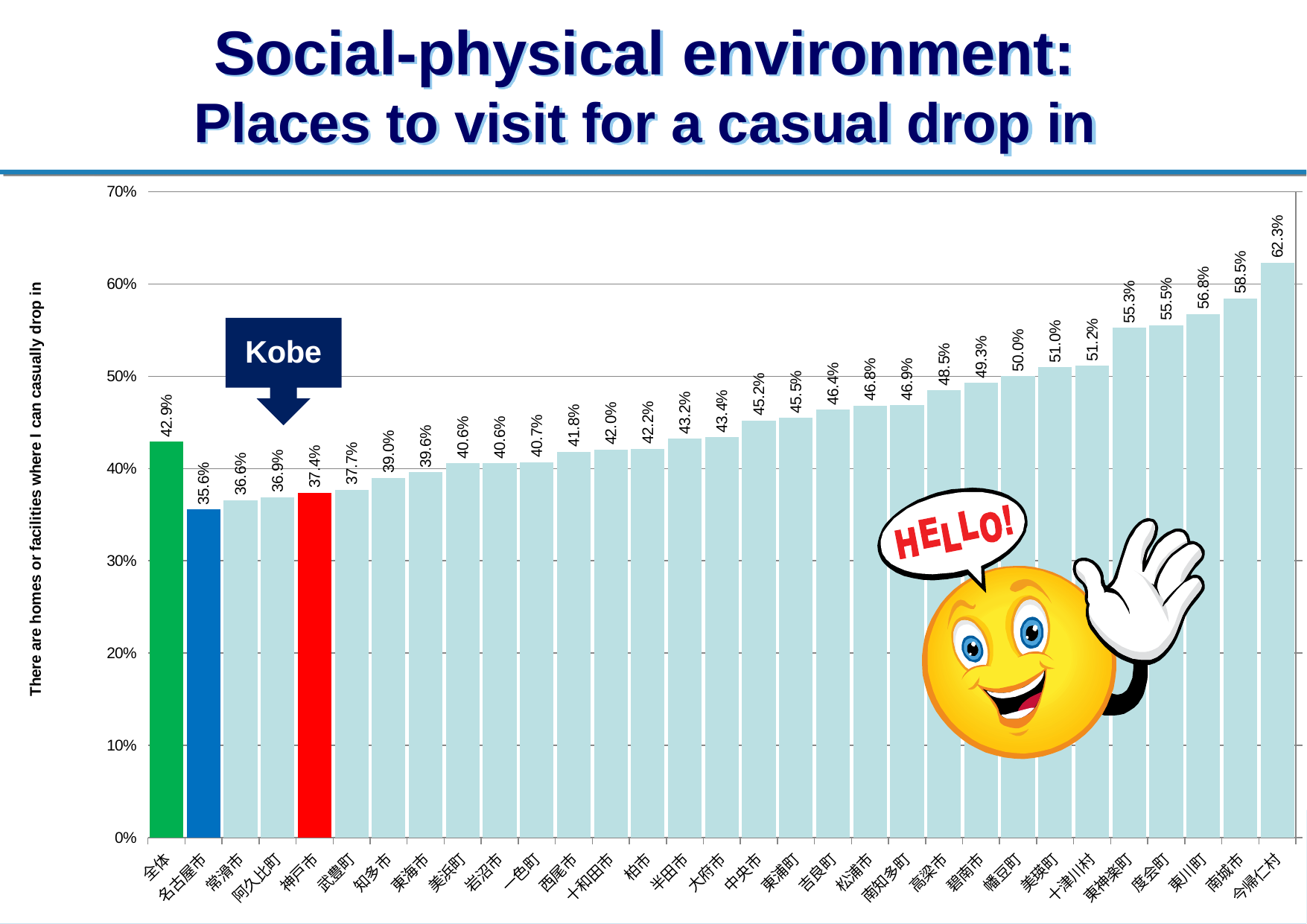
What is the difference between the highest value (今帰仁村) and the lowest value (名古屋市)? 26.7 percentage points How many bars are shown in the chart? 31 What is the value for 全体 (the first bar)? 42.9% What kind of chart is shown on the slide? Bar chart What is the difference between the value for 全体 and the value for 神戸市? 5.5 percentage points What is the value for 今帰仁村? 62.3% Is the value for 幡豆町 greater or less than 40%? greater Which category has the highest value? 今帰仁村 What is the value for 神戸市 (Kobe)? 37.4% What colour is the bar for 神戸市 (Kobe)? Red Which is larger, the value for 南城市 or the value for 東川町? 南城市 Which category has the lowest value? 名古屋市